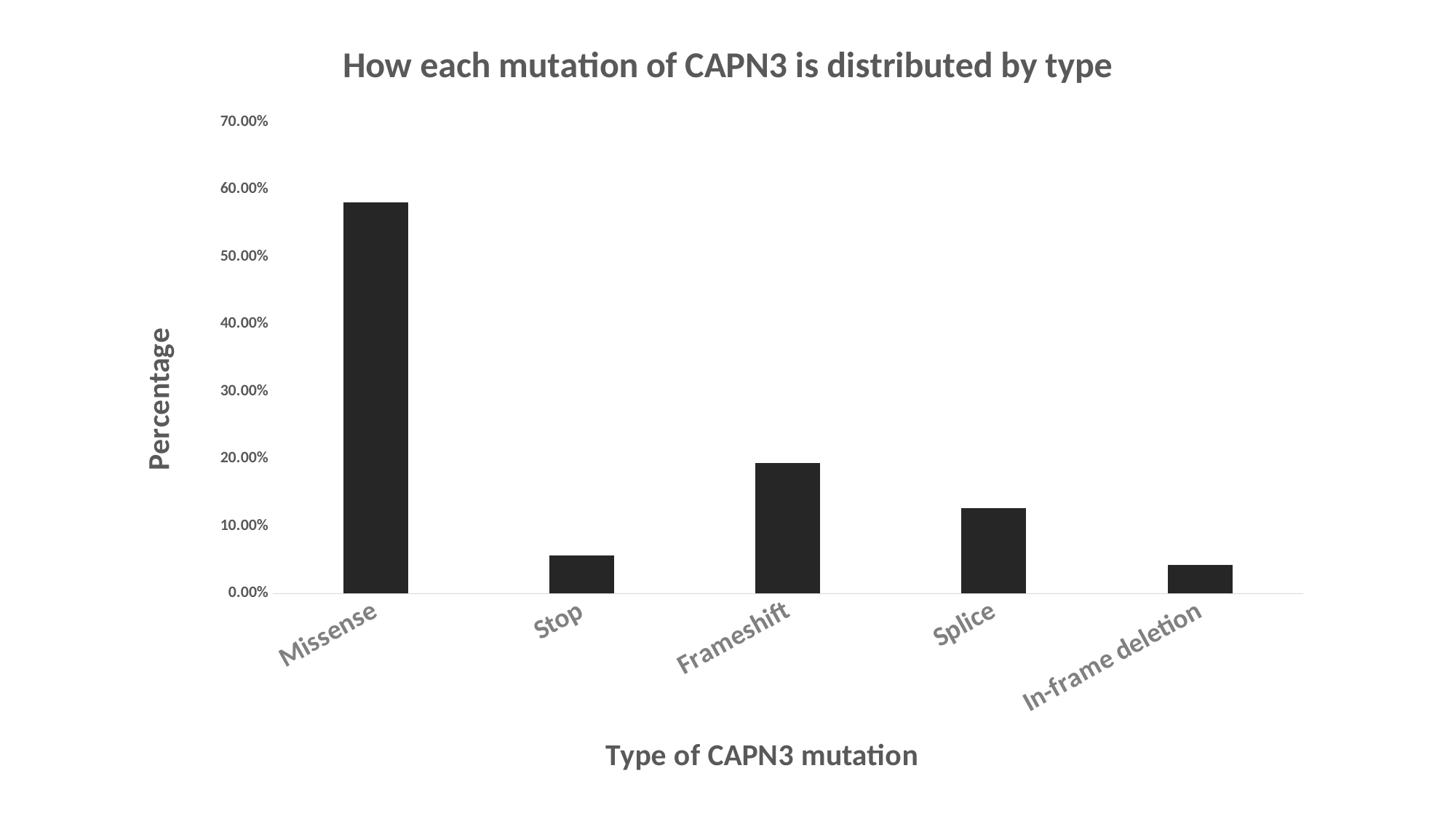
Is the percentage for Splice greater or less than 20.00%? less Is the percentage for Missense greater or less than 50.00%? greater How many mutation types are shown on the x axis? 5 Is the percentage for Frameshift greater or less than 10.00%? greater Which has a higher percentage, Stop or Splice? Splice What is the title of the chart? How each mutation of CAPN3 is distributed by type What kind of chart is shown on the slide? bar chart Which type of CAPN3 mutation has the highest percentage? Missense Which type of CAPN3 mutation has the lowest percentage? In-frame deletion What is the label of the y axis? Percentage Which has a higher percentage, Frameshift or Splice? Frameshift